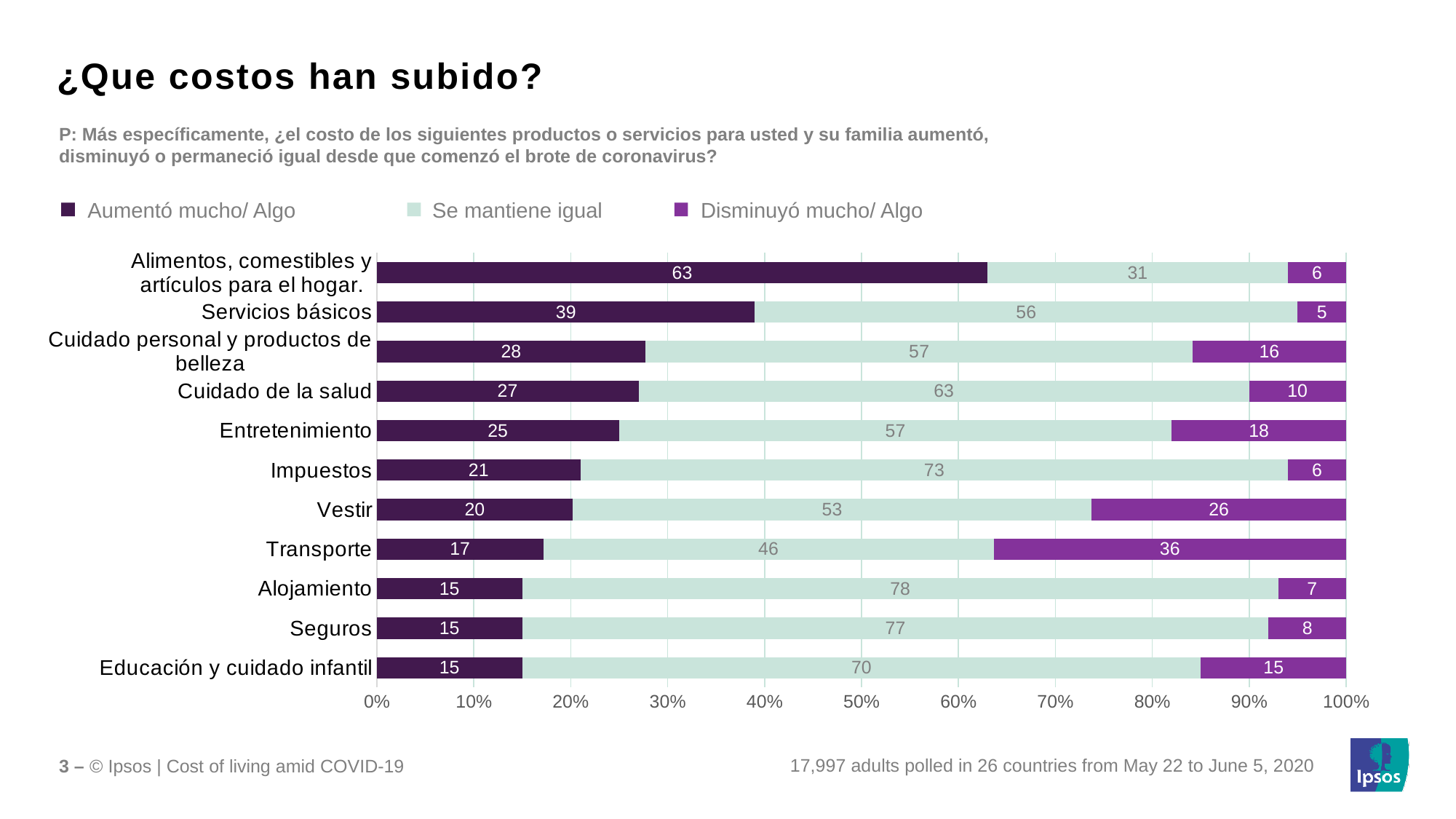
What is the difference between the "Aumentó mucho/ Algo" values for "Servicios básicos" and "Impuestos"? 18 How many categories are shown on the chart? 11 How many series does the legend list? 3 Which category has the lowest value for "Disminuyó mucho/ Algo"? Servicios básicos What is the value of "Aumentó mucho/ Algo" for "Alimentos, comestibles y artículos para el hogar."? 63 Which category has the highest value for "Aumentó mucho/ Algo"? Alimentos, comestibles y artículos para el hogar. What kind of chart is shown on the slide? Stacked bar chart What is the value of "Disminuyó mucho/ Algo" for "Transporte"? 36 What is the title of the chart? ¿Que costos han subido? What is the total of the stacked bar for "Cuidado de la salud"? 100 What is the value of "Se mantiene igual" for "Alojamiento"? 78 Which is larger: the "Disminuyó mucho/ Algo" value for "Vestir" or for "Entretenimiento"? Vestir